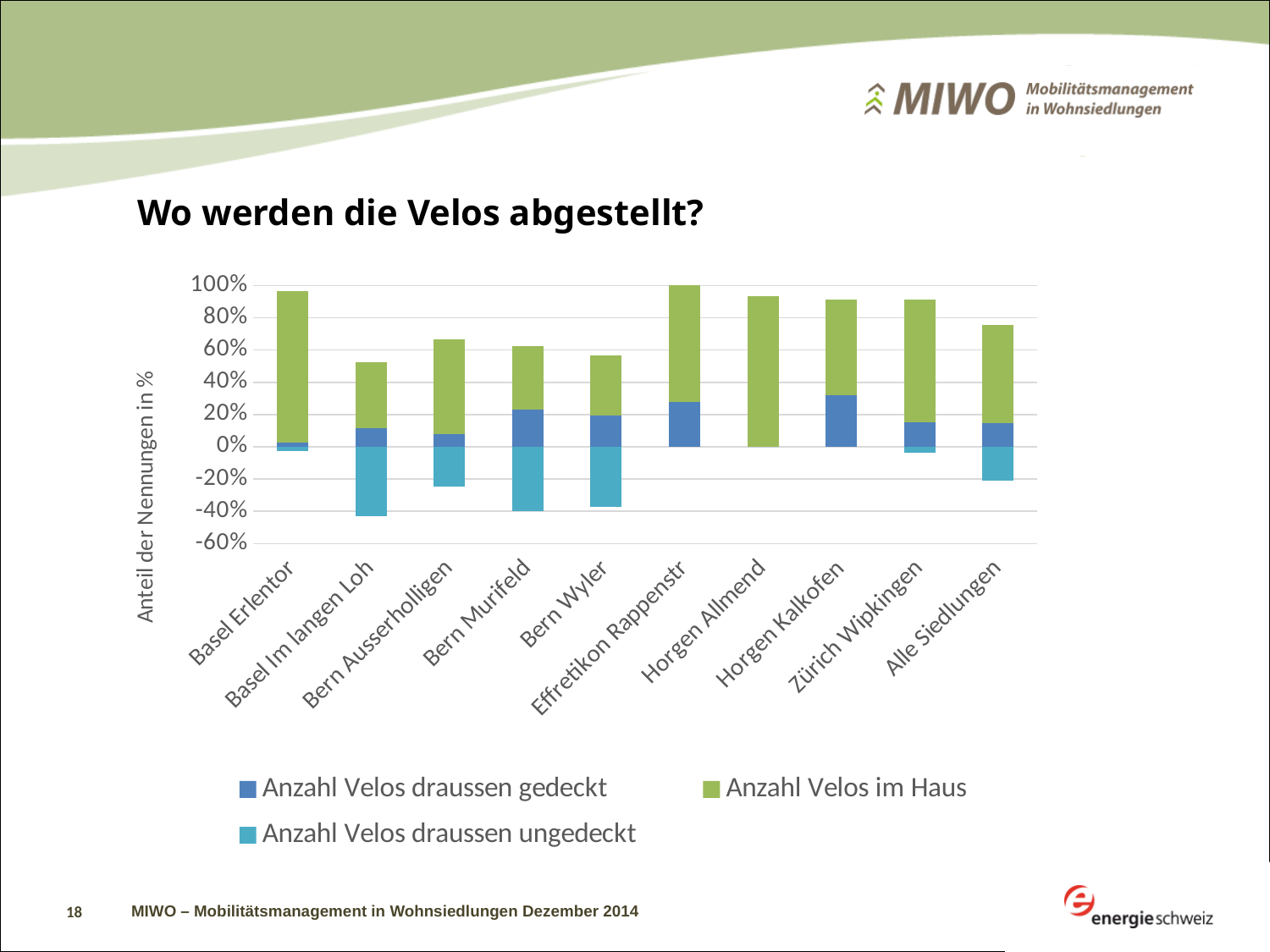
Is the value for Anzahl Velos im Haus at Basel Erlentor greater or less than 80%? greater Is the top of the stacked bar for Alle Siedlungen greater or less than 60%? greater What is the label of the vertical axis? Anteil der Nennungen in % How many series does the legend list? 3 How many categories (settlements) are shown on the x axis? 10 What is the title of the chart? Wo werden die Velos abgestellt? Is the value for Anzahl Velos draussen gedeckt at Horgen Kalkofen greater or less than 20%? greater Which is larger: the top of the stacked bar for Horgen Allmend or for Bern Wyler? Horgen Allmend What kind of chart is shown on the slide? bar chart Which is larger: the Anzahl Velos draussen gedeckt value for Bern Murifeld or for Bern Ausserholligen? Bern Murifeld